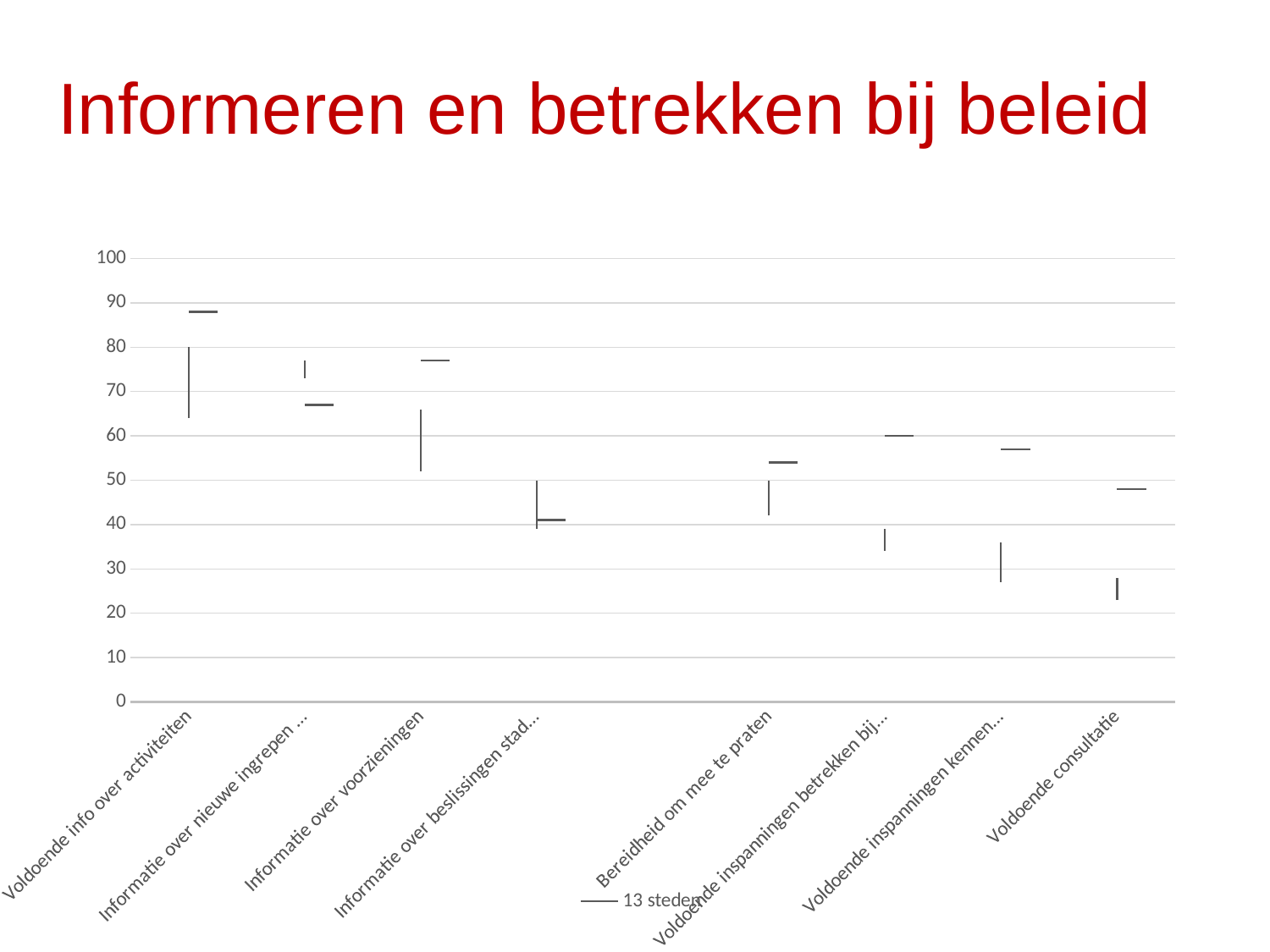
How many categories are shown on the x axis? 8 Is the marker value for 'Voldoende consultatie' greater or less than 60? less Which category has the highest marker value? Voldoende info over activiteiten What entry does the chart's legend list? 13 steden How many series does the legend list? 1 Is the marker value for 'Bereidheid om mee te praten' greater or less than 60? less What is the title of the chart's slide? Informeren en betrekken bij beleid Which has the larger marker value: 'Voldoende info over activiteiten' or 'Voldoende consultatie'? Voldoende info over activiteiten Which has the larger marker value: 'Informatie over voorzieningen' or 'Bereidheid om mee te praten'? Informatie over voorzieningen